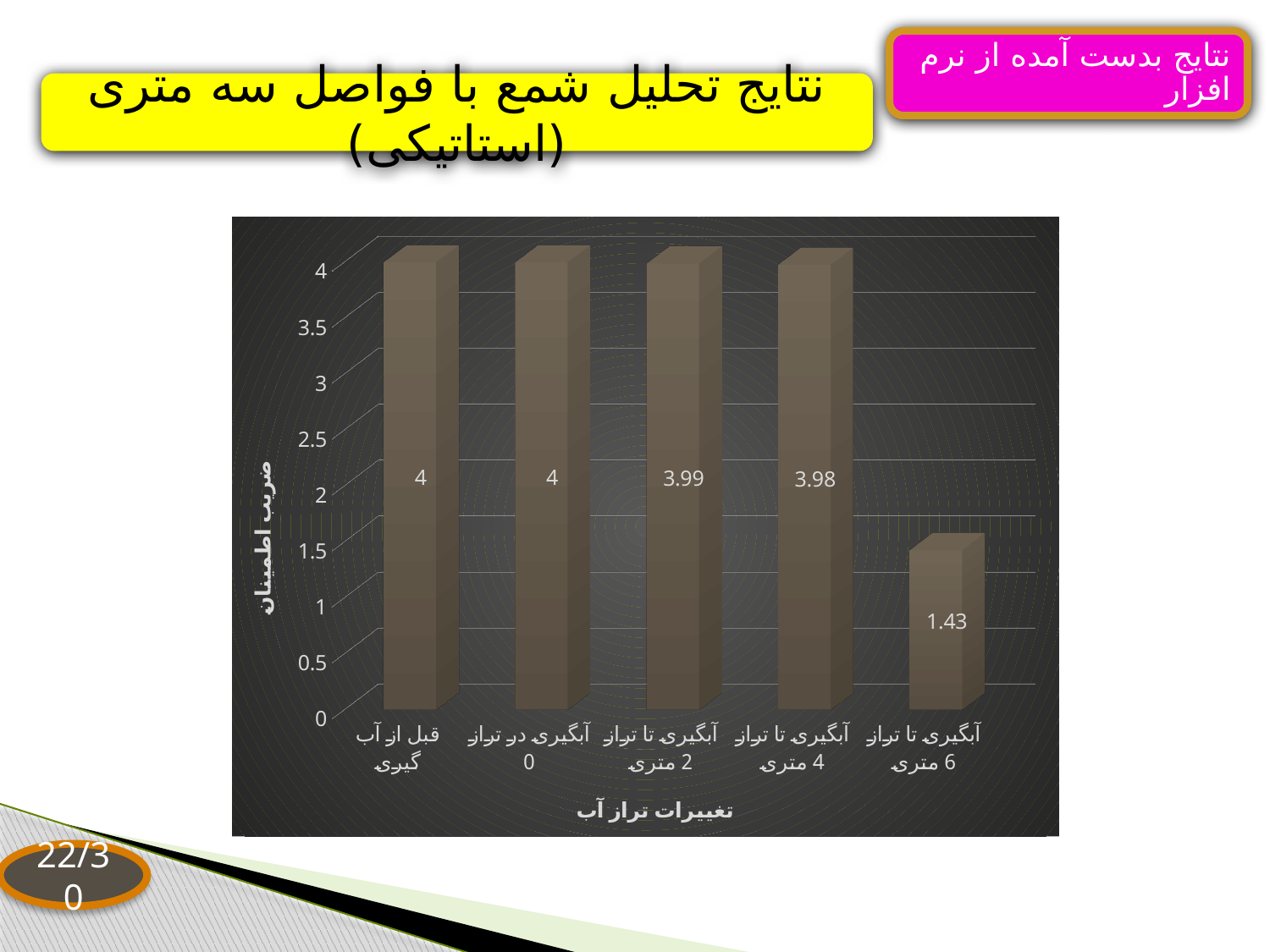
What kind of chart is shown on the slide? bar chart What is the value for the category "قبل از آب گیری"? 4 Which category has the lowest value? آبگیری تا تراز 6 متری What is the difference between the values for "آبگیری تا تراز 4 متری" and "آبگیری تا تراز 6 متری"? 2.55 How many categories are shown on the x axis? 5 What is the title of the vertical axis? ضریب اطمینان Is the value for "آبگیری تا تراز 6 متری" greater or less than 2? less What is the value for the category "آبگیری تا تراز 6 متری"? 1.43 What is the value for the category "آبگیری تا تراز 4 متری"? 3.98 Which is larger, the value for "آبگیری در تراز 0" or the value for "آبگیری تا تراز 6 متری"? آبگیری در تراز 0 What is the difference between the values for "قبل از آب گیری" and "آبگیری تا تراز 2 متری"? 0.01 What is the value for the category "آبگیری تا تراز 2 متری"? 3.99